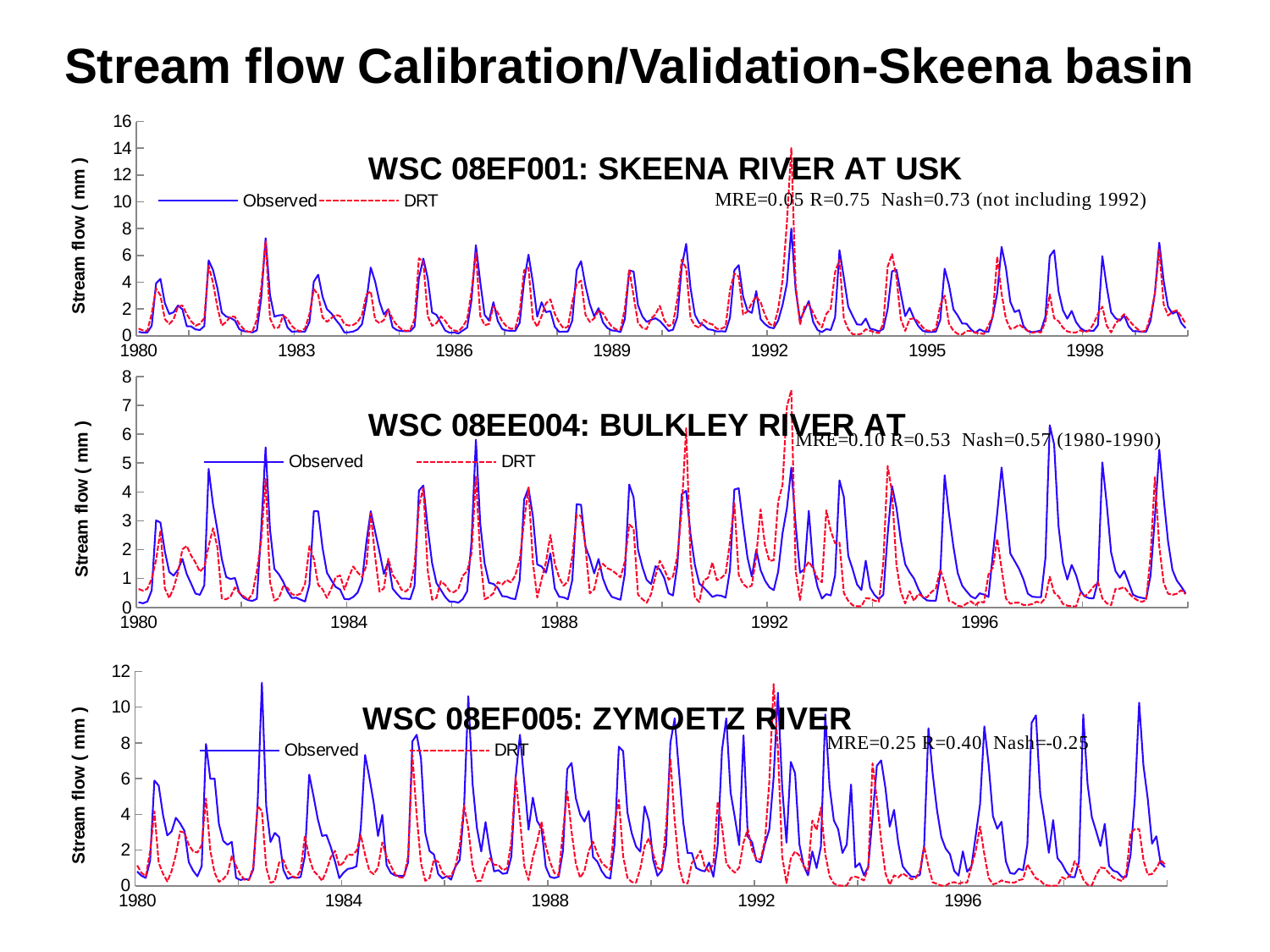
How many series does the legend of the top chart (SKEENA RIVER AT USK) list? 2 In the middle chart (BULKLEY RIVER AT), which series reaches the higher peak in 1981, Observed or DRT? Observed In the bottom chart (ZYMOETZ RIVER), is the peak Observed value in 1982 greater or less than 10? greater In the bottom chart (ZYMOETZ RIVER), is the peak DRT value in 1981 greater or less than 6? less In the top chart (SKEENA RIVER AT USK), is the peak Observed value in 1982 greater or less than 8? less What are the two series named in the legend of the middle chart (BULKLEY RIVER AT)? Observed and DRT In the top chart (SKEENA RIVER AT USK), which series reaches the higher peak in 1992, Observed or DRT? DRT What kind of chart is the top chart, WSC 08EF001: SKEENA RIVER AT USK? line chart In the bottom chart (ZYMOETZ RIVER), which series is drawn as a red dashed line? DRT In the bottom chart (ZYMOETZ RIVER), which series reaches the higher peak in 1982, Observed or DRT? Observed